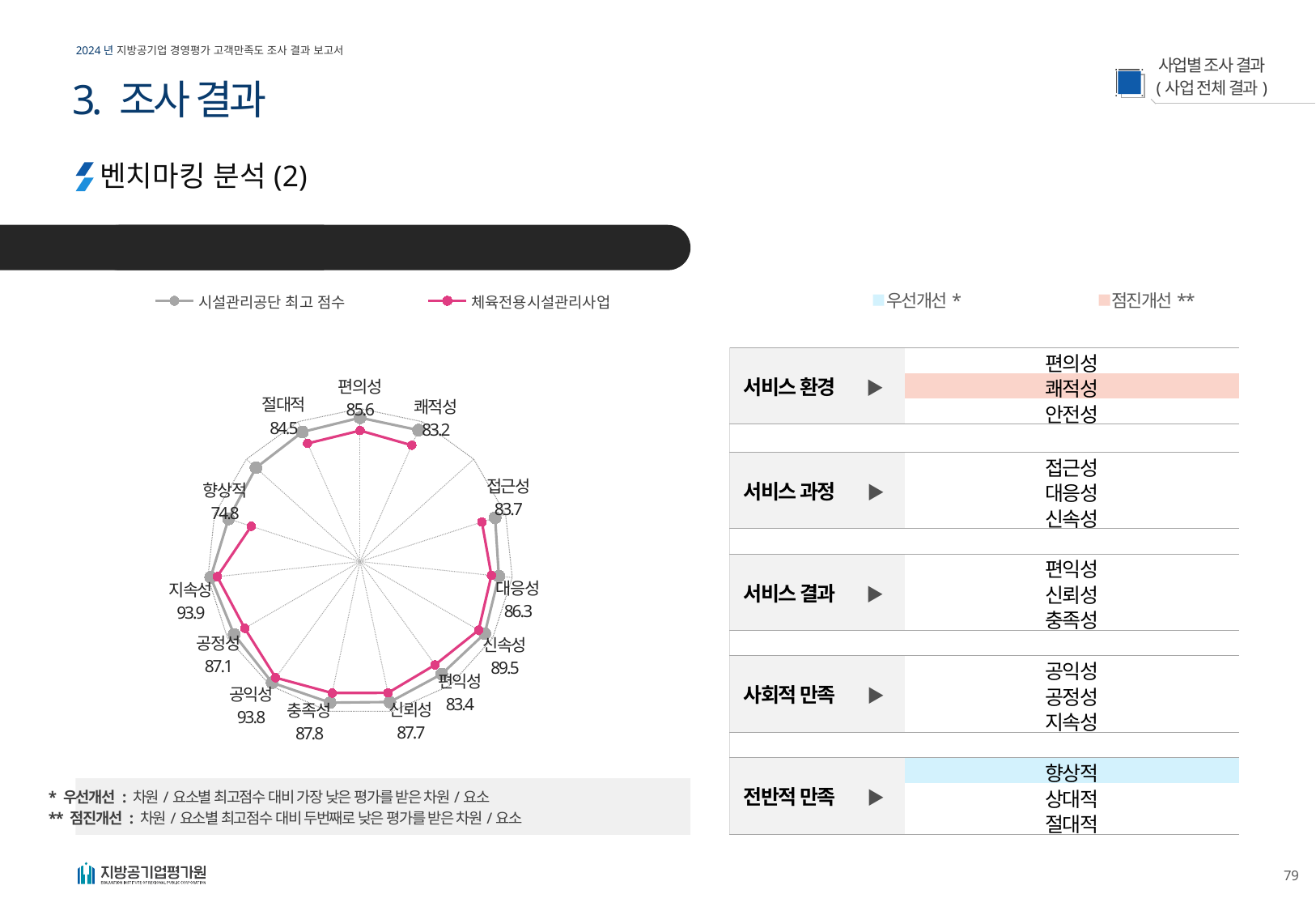
What is the difference between the labeled values for 지속성 and 향상적? 19.1 Which has the larger labeled value on the radar chart, 편의성 or 쾌적성? 편의성 What value is labeled for 신속성 on the radar chart? 89.5 Which category has the lowest labeled value on the radar chart? 향상적 What value is labeled for 편의성 on the radar chart? 85.6 Which series in the radar chart legend is drawn in pink? 체육전용시설관리사업 Which category has the highest labeled value on the radar chart? 지속성 How many series does the radar chart's legend list? 2 How many categories (axes) does the radar chart have? 15 What value is labeled for 공익성 on the radar chart? 93.8 What value is labeled for 향상적 on the radar chart? 74.8 What kind of chart is shown on the left of the slide? Radar chart